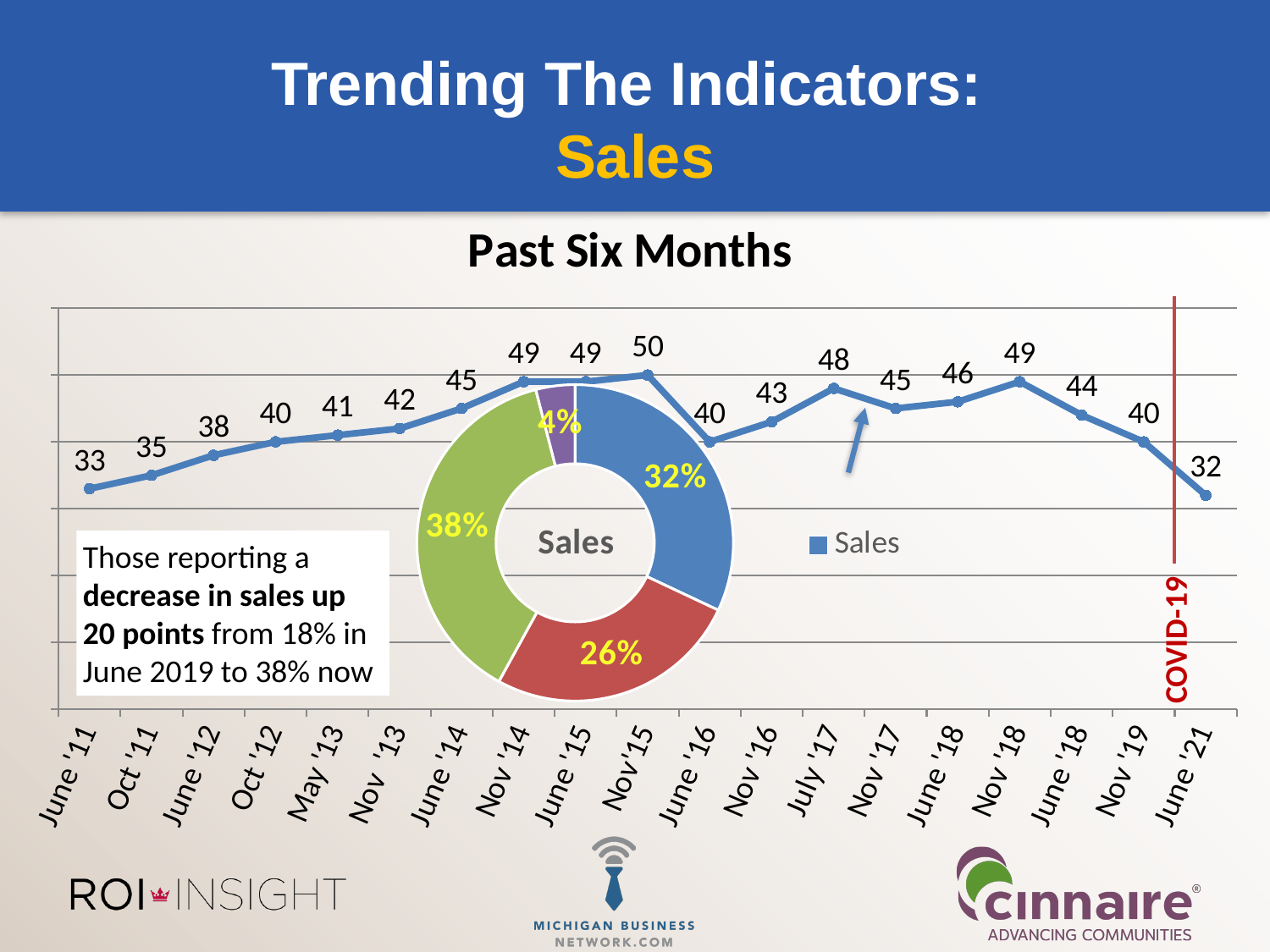
What kind of chart is the chart titled 'Past Six Months'? line chart On the line chart titled 'Past Six Months', which category has the lowest value? June '21 On the line chart titled 'Past Six Months', which is larger, the value for July '17 or the value for Nov '17? July '17 On the line chart titled 'Past Six Months', what is the value for Nov '15? 50 On the line chart titled 'Past Six Months', do the values rise or fall from Nov '18 to June '21? fall On the line chart titled 'Past Six Months', what is the difference between the values for Nov '19 and June '21? 8 On the donut chart labeled 'Sales' in the middle of the slide, what is the largest share shown? 38% On the line chart titled 'Past Six Months', what is the value for June '21? 32 On the line chart titled 'Past Six Months', which category has the highest value? Nov '15 On the line chart titled 'Past Six Months', how many data points are plotted? 19 On the line chart titled 'Past Six Months', what is the value for June '11? 33